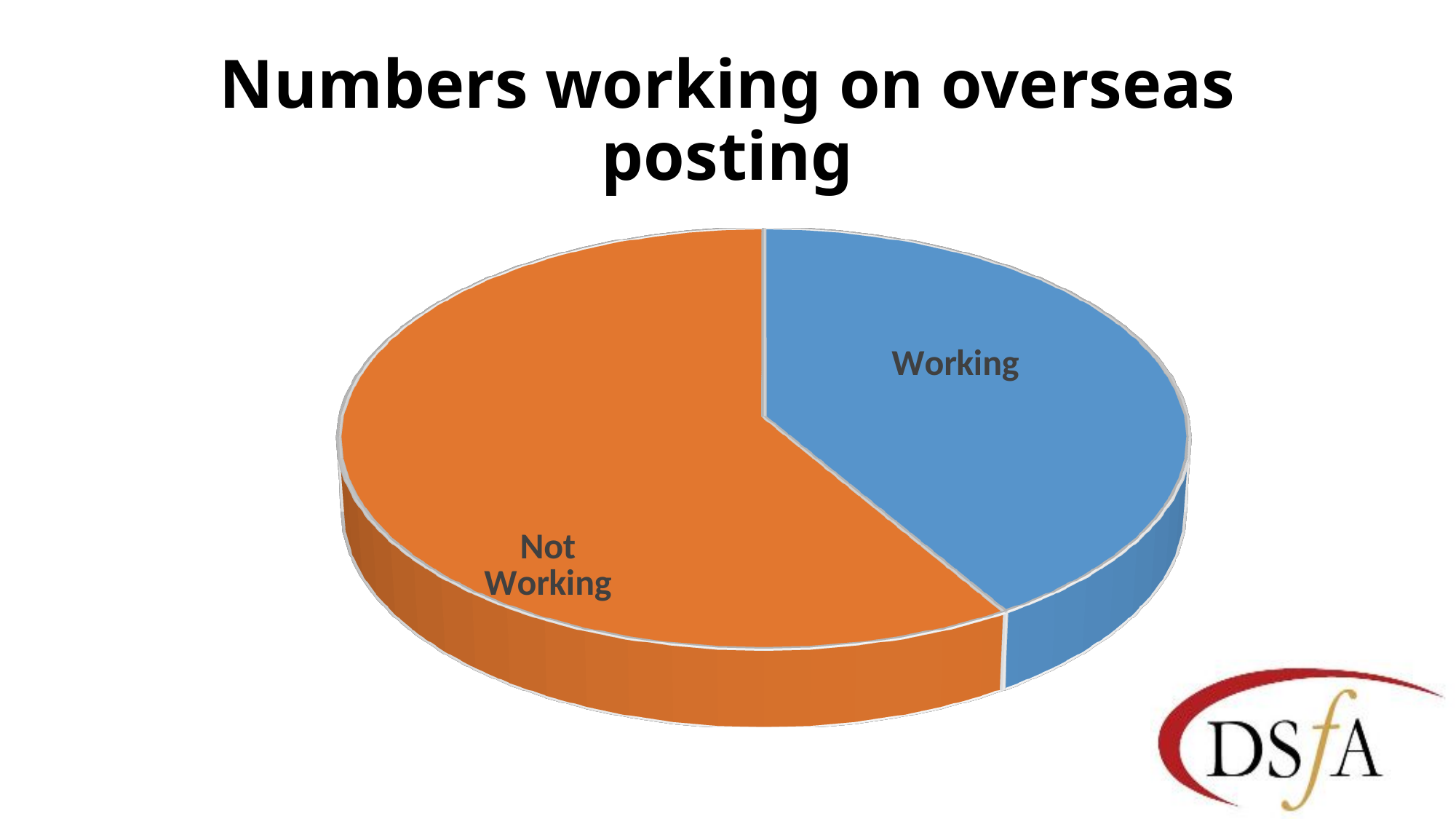
Which slice of the pie is the smallest? Working How many slices does the pie chart have? 2 What is the title of the chart? Numbers working on overseas posting What colour is the Working slice? blue Which slice of the pie is the largest? Not Working Which slice is larger, Working or Not Working? Not Working Is the Not Working slice more or less than half of the pie? more What kind of chart is shown on the slide? pie chart